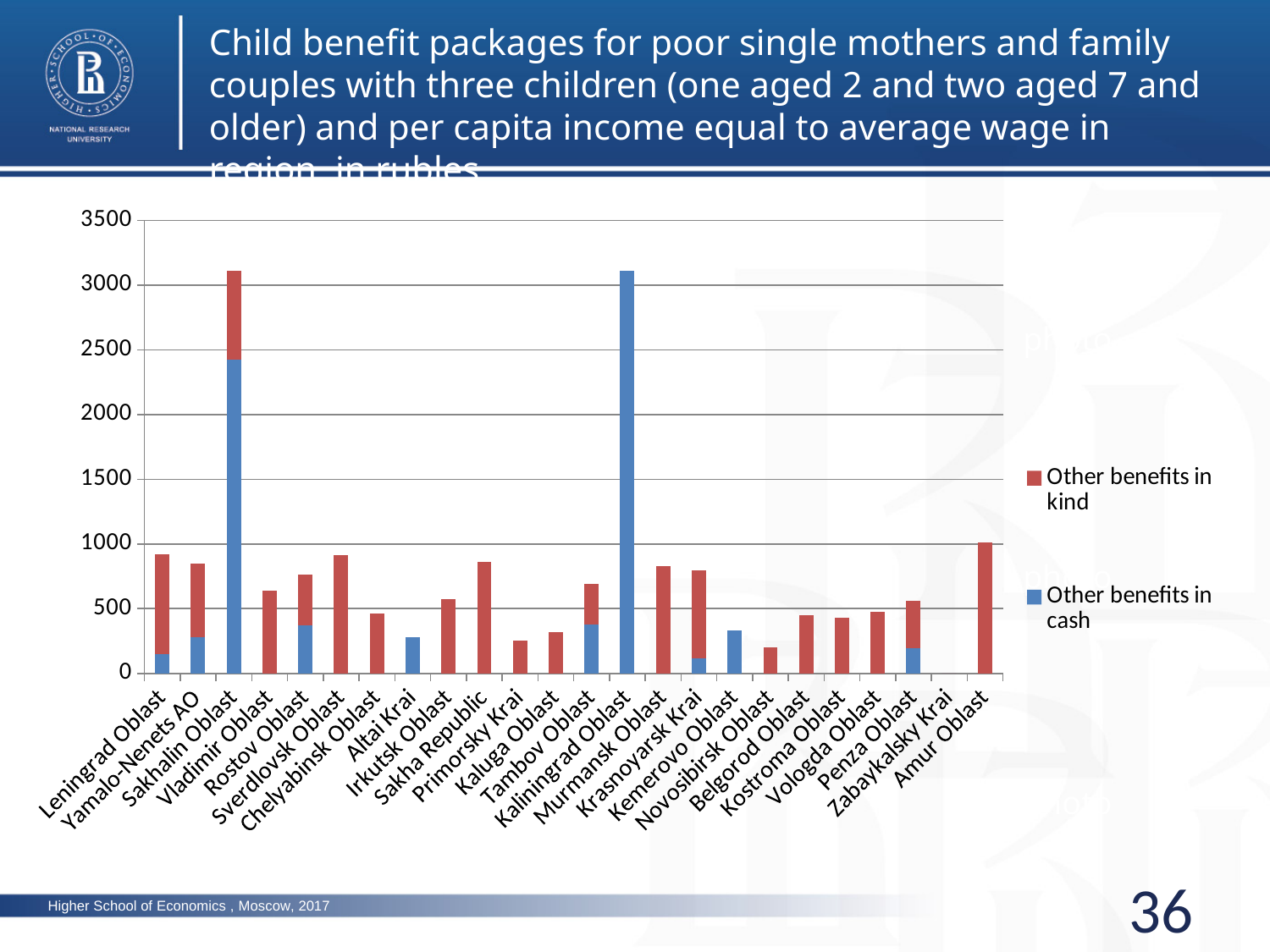
How many series does the legend list? 2 Is the total value for Belgorod Oblast greater or less than 500? less Is the 'Other benefits in cash' value for Sakhalin Oblast greater or less than 2000? greater Which series is shown in red in the legend? Other benefits in kind Is the total value for Leningrad Oblast greater or less than 1000? less Which series is shown in blue in the legend? Other benefits in cash How many regions are shown on the x axis of the chart? 24 Which has the larger total value, Kaliningrad Oblast or Murmansk Oblast? Kaliningrad Oblast What kind of chart is shown on the slide? bar chart Which has the larger total value, Sakhalin Oblast or Leningrad Oblast? Sakhalin Oblast